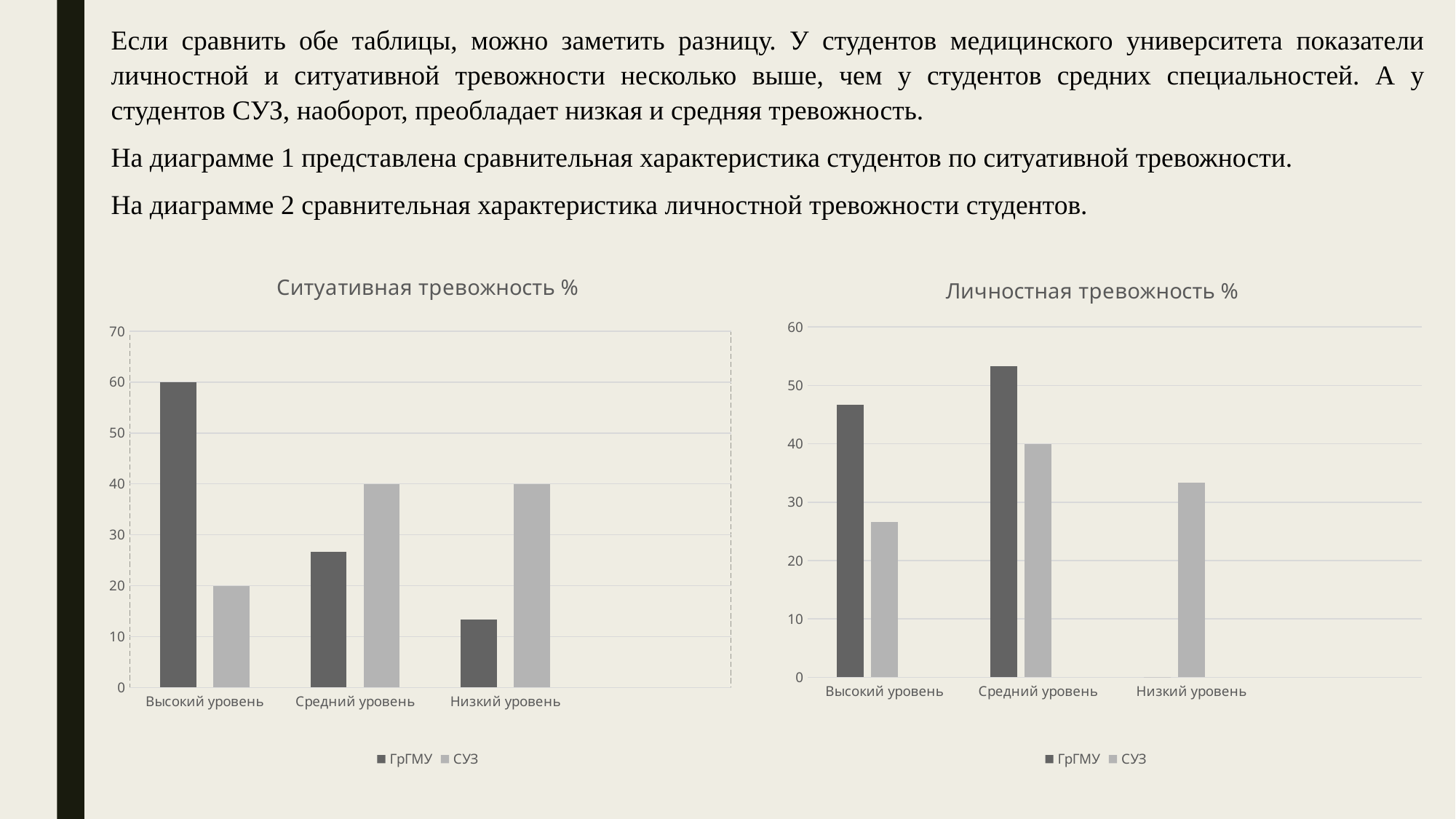
In the chart titled "Ситуативная тревожность %", which category has the highest value for ГрГМУ? Высокий уровень What kind of chart is the chart titled "Ситуативная тревожность %"? bar chart In the chart titled "Ситуативная тревожность %", is the value for ГрГМУ at Низкий уровень greater or less than 20? less In the chart titled "Ситуативная тревожность %", what is the value for ГрГМУ at Высокий уровень? 60 In the chart titled "Личностная тревожность %", which is larger at Высокий уровень, ГрГМУ or СУЗ? ГрГМУ In the chart titled "Личностная тревожность %", what is the value for СУЗ at Средний уровень? 40 In the chart titled "Ситуативная тревожность %", what is the value for СУЗ at Высокий уровень? 20 In the chart titled "Ситуативная тревожность %", what is the difference between ГрГМУ and СУЗ at Высокий уровень? 40 In the chart titled "Личностная тревожность %", is the value for ГрГМУ at Средний уровень greater or less than 50? greater How many series does the legend of the chart titled "Личностная тревожность %" list? 2 In the chart titled "Ситуативная тревожность %", does the ГрГМУ series rise or fall from Высокий уровень to Низкий уровень? fall In the chart titled "Ситуативная тревожность %", what is the value for СУЗ at Средний уровень? 40